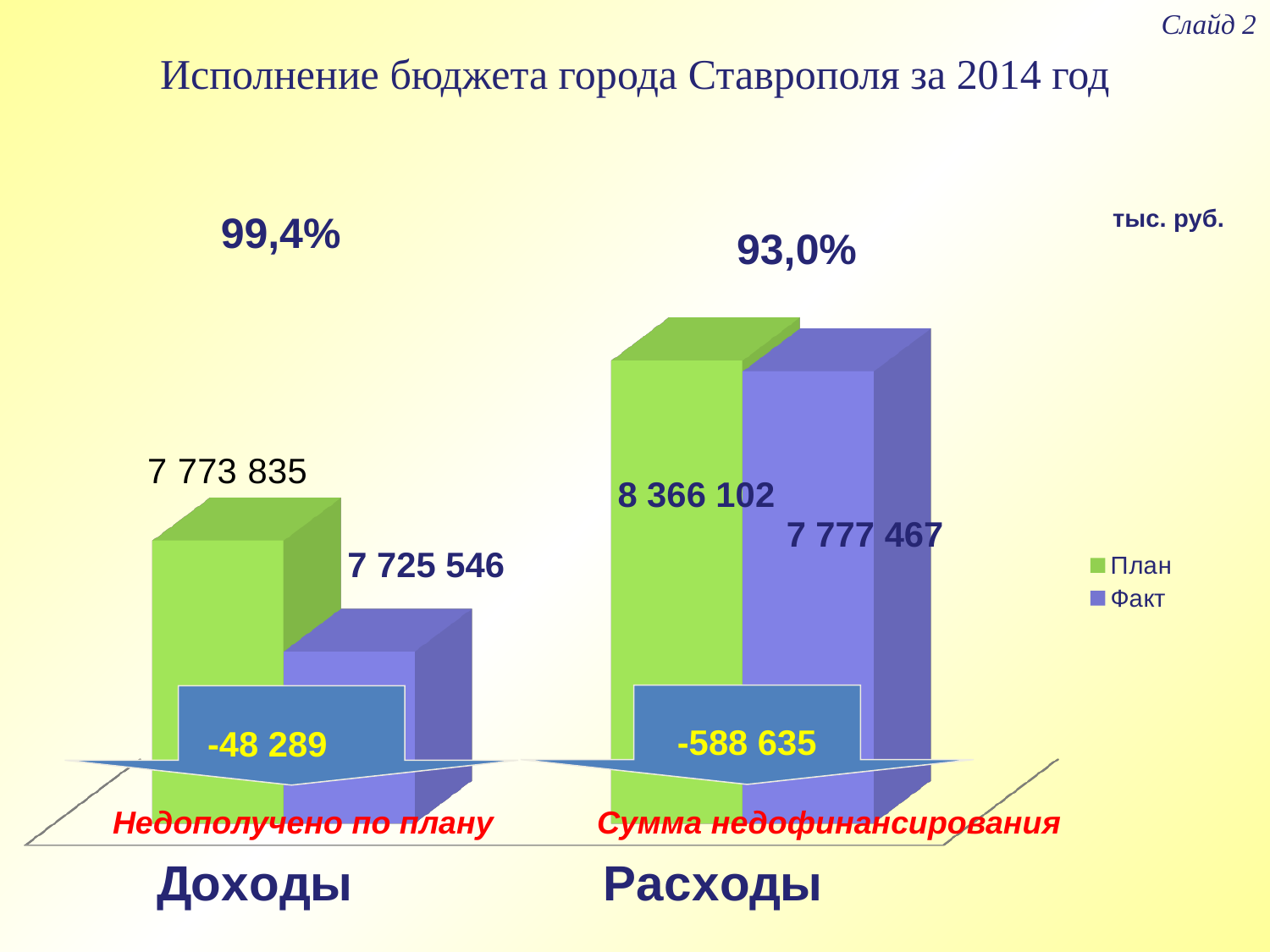
What is the Факт value for Доходы? 7 725 546 What is the difference between the Факт and План values for Расходы, as shown on the slide? -588 635 Which bar is the lowest on the chart? Факт for Доходы What is the difference between the Факт and План values for Доходы, as shown on the slide? -48 289 How many categories are shown on the chart? 2 What is the План value for Доходы? 7 773 835 What kind of chart is shown on the slide? Bar chart Which is larger for Расходы: the План value or the Факт value? План What is the Факт value for Расходы? 7 777 467 What is the План value for Расходы? 8 366 102 Which category has the highest План value? Расходы How many series does the legend list? 2